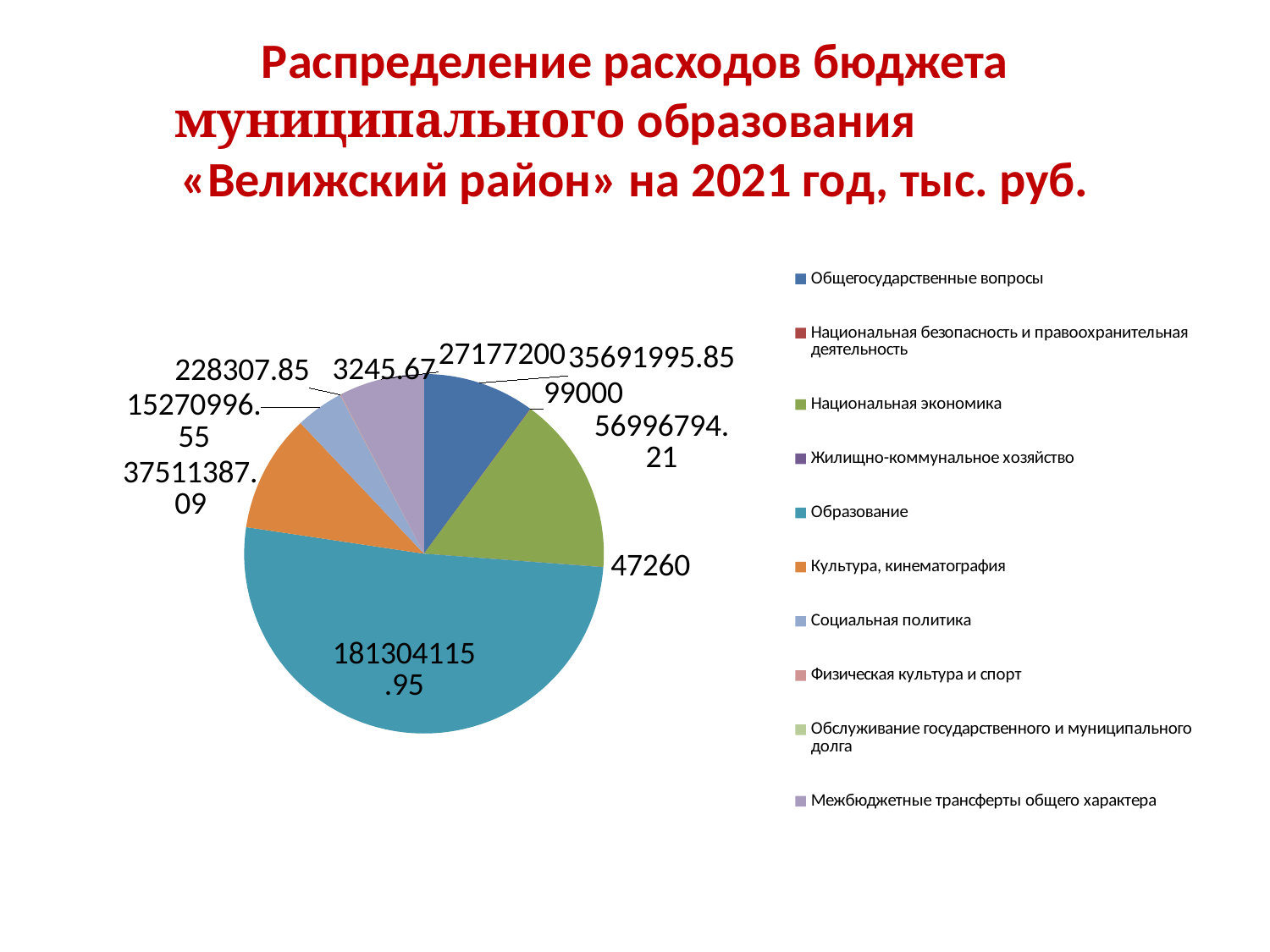
What is the value shown for Социальная политика? 15270996.55 What is the value shown for Культура, кинематография? 37511387.09 What is the value shown for Образование? 181304115.95 Which is larger, the slice for Культура, кинематография or the slice for Социальная политика? Культура, кинематография What is the value shown for Общегосударственные вопросы? 35691995.85 How many categories does the legend of the pie chart list? 10 What is the difference between the values for Образование and Культура, кинематография? 143792728.86 For which year does the chart title say the budget expenditures are distributed? 2021 Which is larger, the slice for Образование or the slice for Национальная экономика? Образование Which category has the largest slice of the pie chart? Образование What kind of chart is shown on the slide? pie chart What colour is the slice for Образование? teal